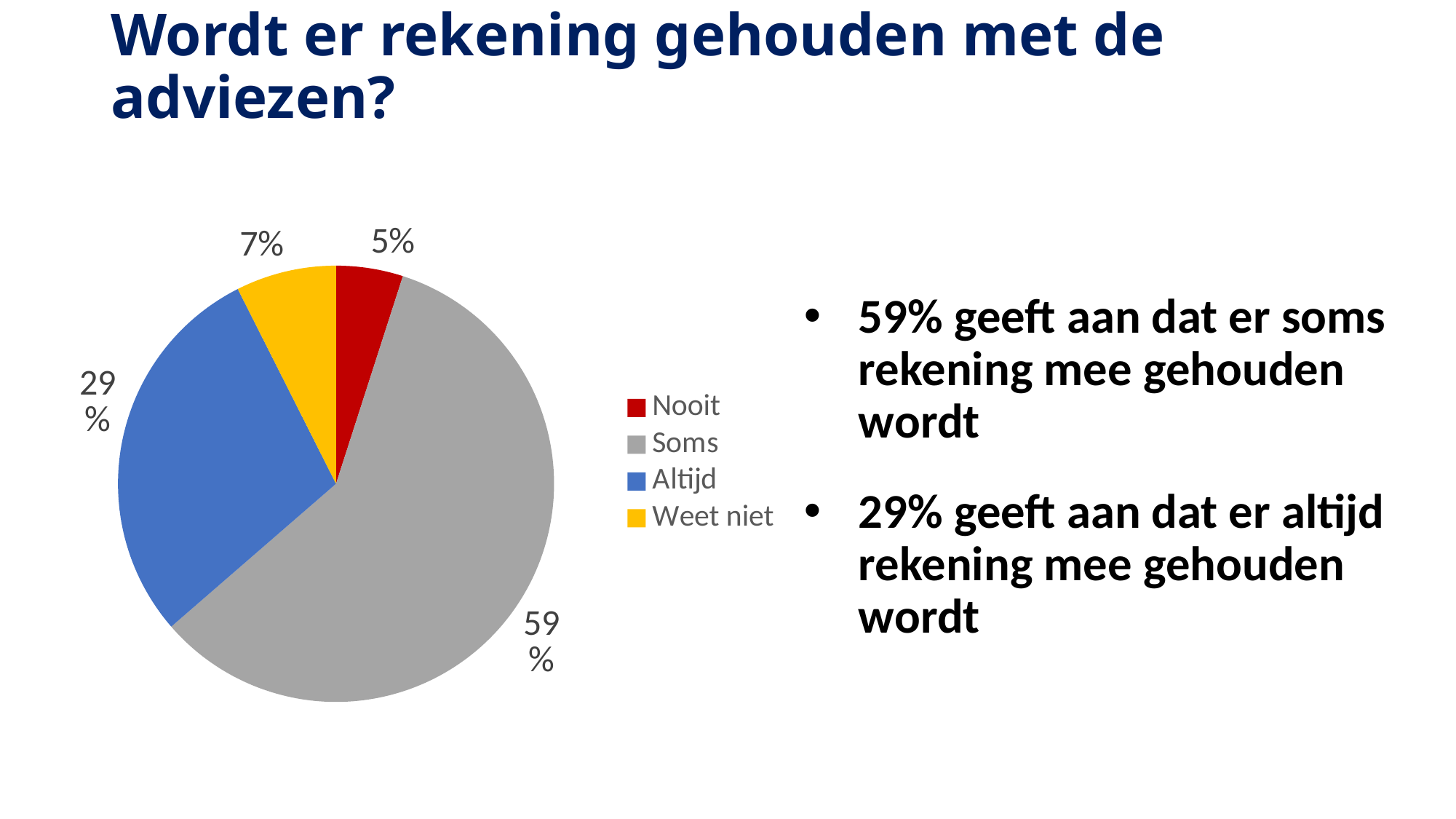
What is the difference in percentage points between the 'Soms' and 'Altijd' slices? 30 Which category has the smallest slice of the pie? Nooit How many categories does the pie chart have? 4 How many entries does the legend list? 4 Which slice is larger, 'Weet niet' or 'Nooit'? Weet niet What percentage of the pie is the 'Nooit' slice? 5% What colour is the 'Altijd' slice in the pie chart? blue What percentage of the pie is the 'Weet niet' slice? 7% What kind of chart is shown on the slide? pie chart Which category has the largest slice of the pie? Soms What percentage of the pie is the 'Altijd' slice? 29% What percentage of the pie is the 'Soms' slice? 59%